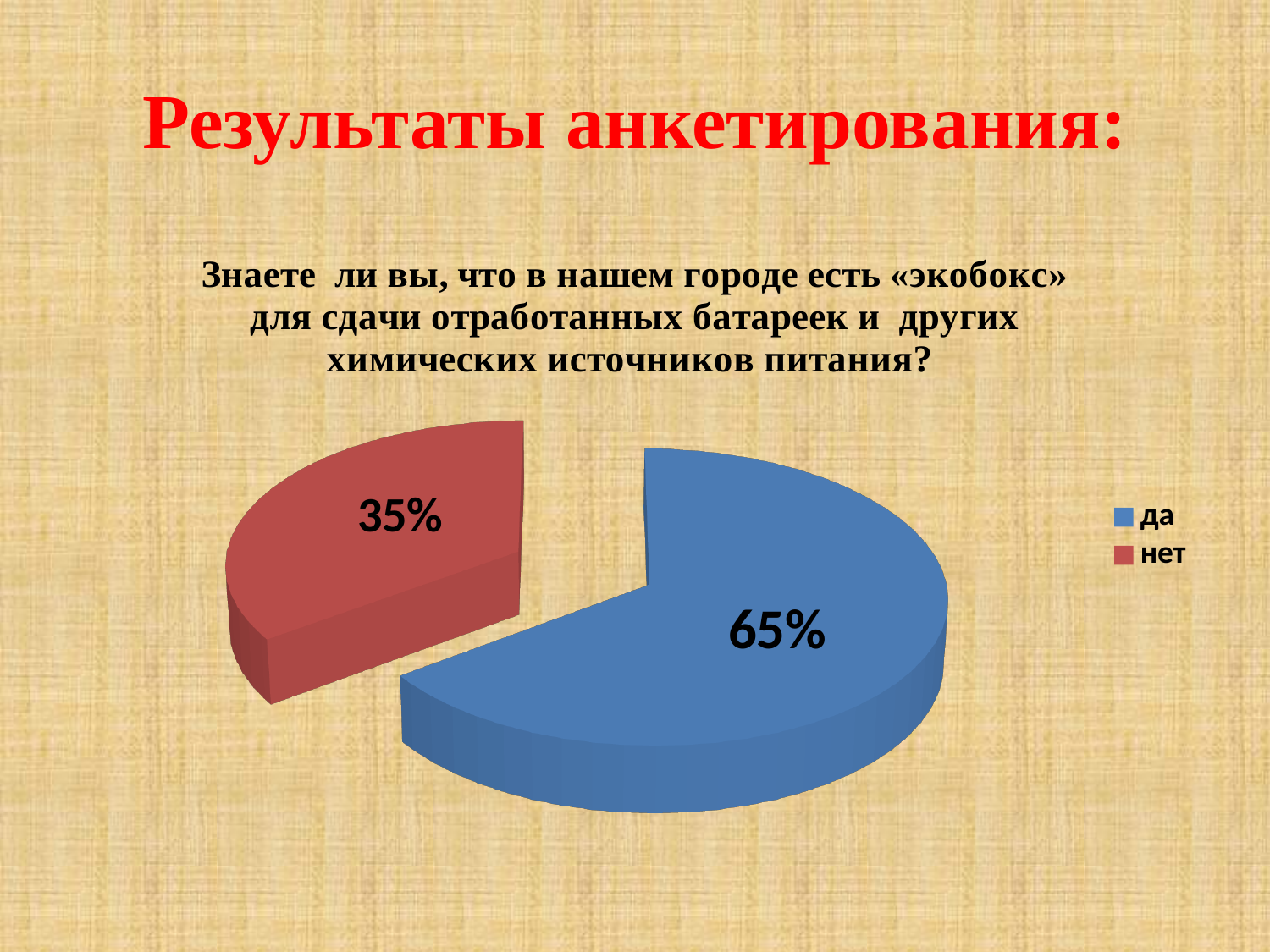
What kind of chart is shown on the slide? pie chart What share of the pie does "да" take? 65% What colour is the slice for "нет"? red What share of the pie does "нет" take? 35% Which is larger, the share for "да" or the share for "нет"? да Which category has the smallest slice of the pie? нет Which category has the largest slice of the pie? да What colour is the slice for "да"? blue How many slices does the pie chart have? 2 How many entries does the legend list? 2 What is the difference between the shares for "да" and "нет"? 30%